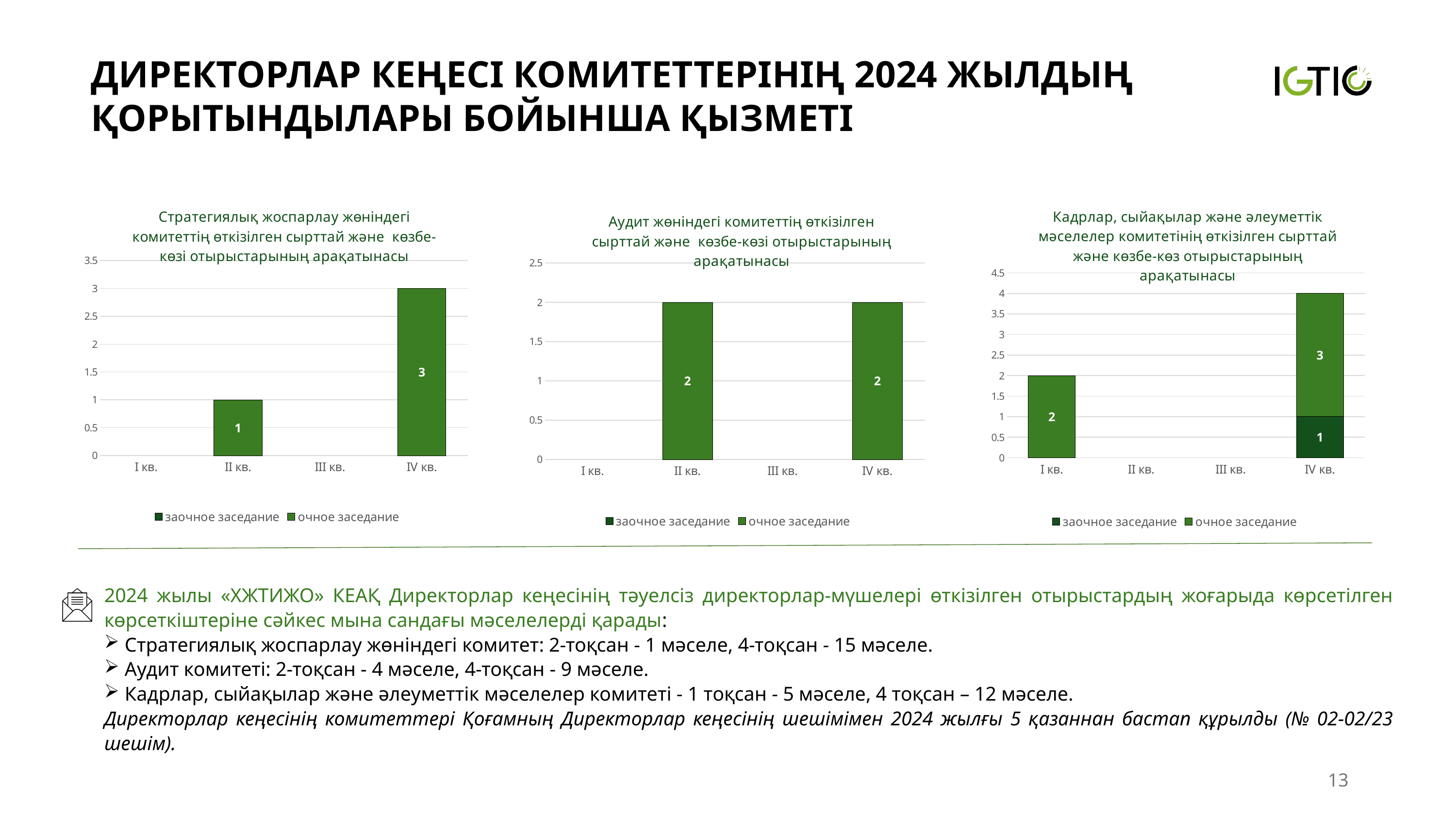
In the middle chart (Аудит жөніндегі комитет), what is the value for IV кв.? 2 In the left chart (Стратегиялық жоспарлау жөніндегі комитет), which quarter has the highest value? IV кв. In the left chart (Стратегиялық жоспарлау жөніндегі комитет), what is the value for II кв.? 1 In the right chart (Кадрлар, сыйақылар және әлеуметтік мәселелер комитеті), which is larger: the total for I кв. or the total for IV кв.? IV кв. What type of chart is the left chart (Стратегиялық жоспарлау жөніндегі комитет)? Bar chart In the right chart (Кадрлар, сыйақылар және әлеуметтік мәселелер комитеті), what is the total of the stacked bar for IV кв.? 4 In the right chart (Кадрлар, сыйақылар және әлеуметтік мәселелер комитеті), what is the value for I кв.? 2 In the left chart (Стратегиялық жоспарлау жөніндегі комитет), what is the value for IV кв.? 3 In the left chart (Стратегиялық жоспарлау жөніндегі комитет), what is the difference between the values for IV кв. and II кв.? 2 How many series does the legend of the middle chart (Аудит жөніндегі комитет) list? 2 In the right chart (Кадрлар, сыйақылар және әлеуметтік мәселелер комитеті), what is the value of the заочное заседание series for IV кв.? 1 In the middle chart (Аудит жөніндегі комитет), what is the value for II кв.? 2